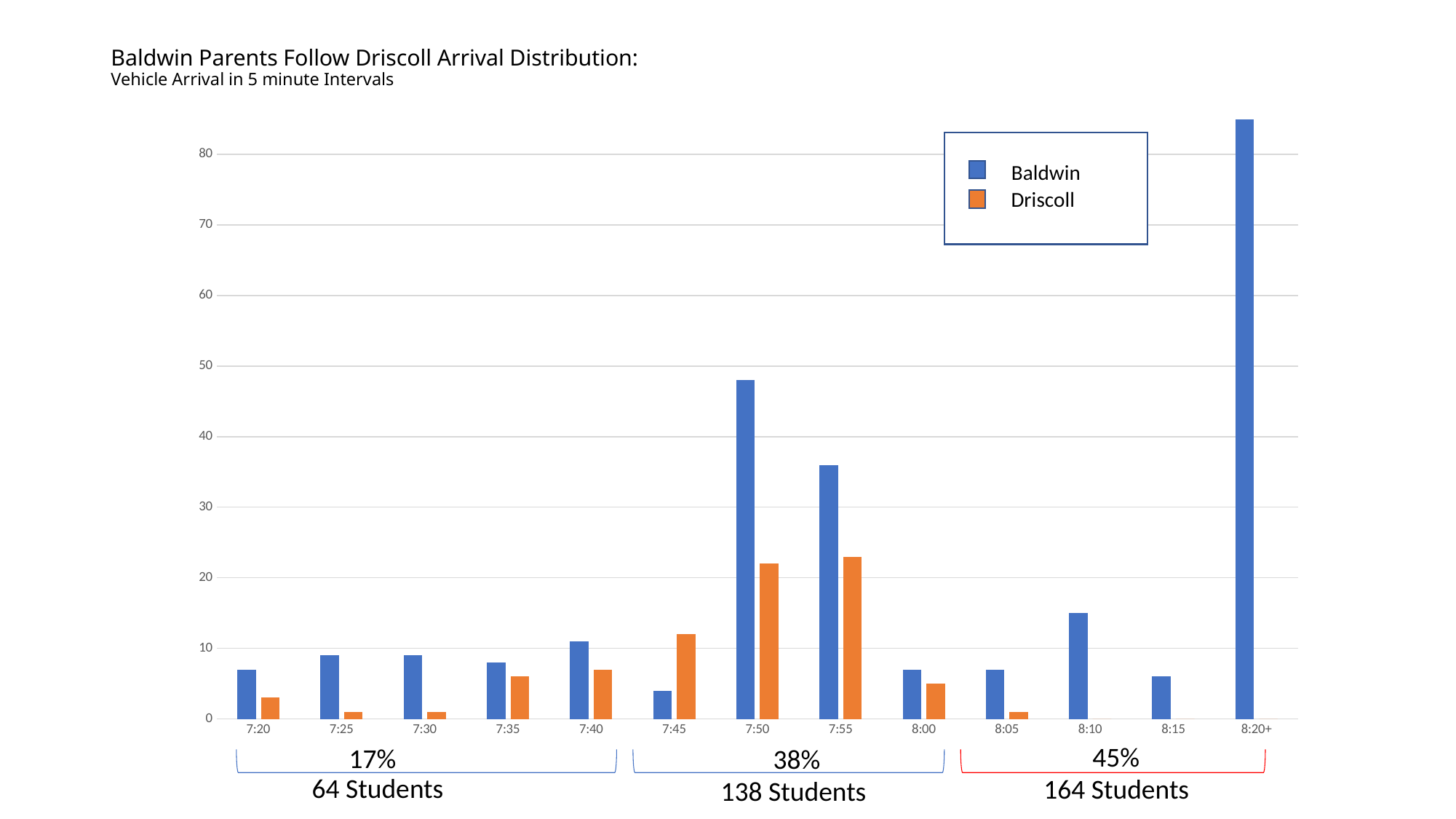
According to the annotation below the chart, how many students arrive in the 8:05 to 8:20+ group? 164 Students How many time intervals are shown on the x axis? 13 Is the Baldwin value for 7:20 greater or less than 10? less Which time interval has the highest Baldwin value? 8:20+ Is the Baldwin value for 7:55 greater or less than 30? greater What kind of chart is shown on the slide? Bar chart How many series does the legend list? 2 Which time interval has the lowest Baldwin value? 7:45 Is the Baldwin value for 8:20+ greater or less than 80? greater At 7:50, which series has the larger value, Baldwin or Driscoll? Baldwin At 7:45, which series has the larger value, Baldwin or Driscoll? Driscoll